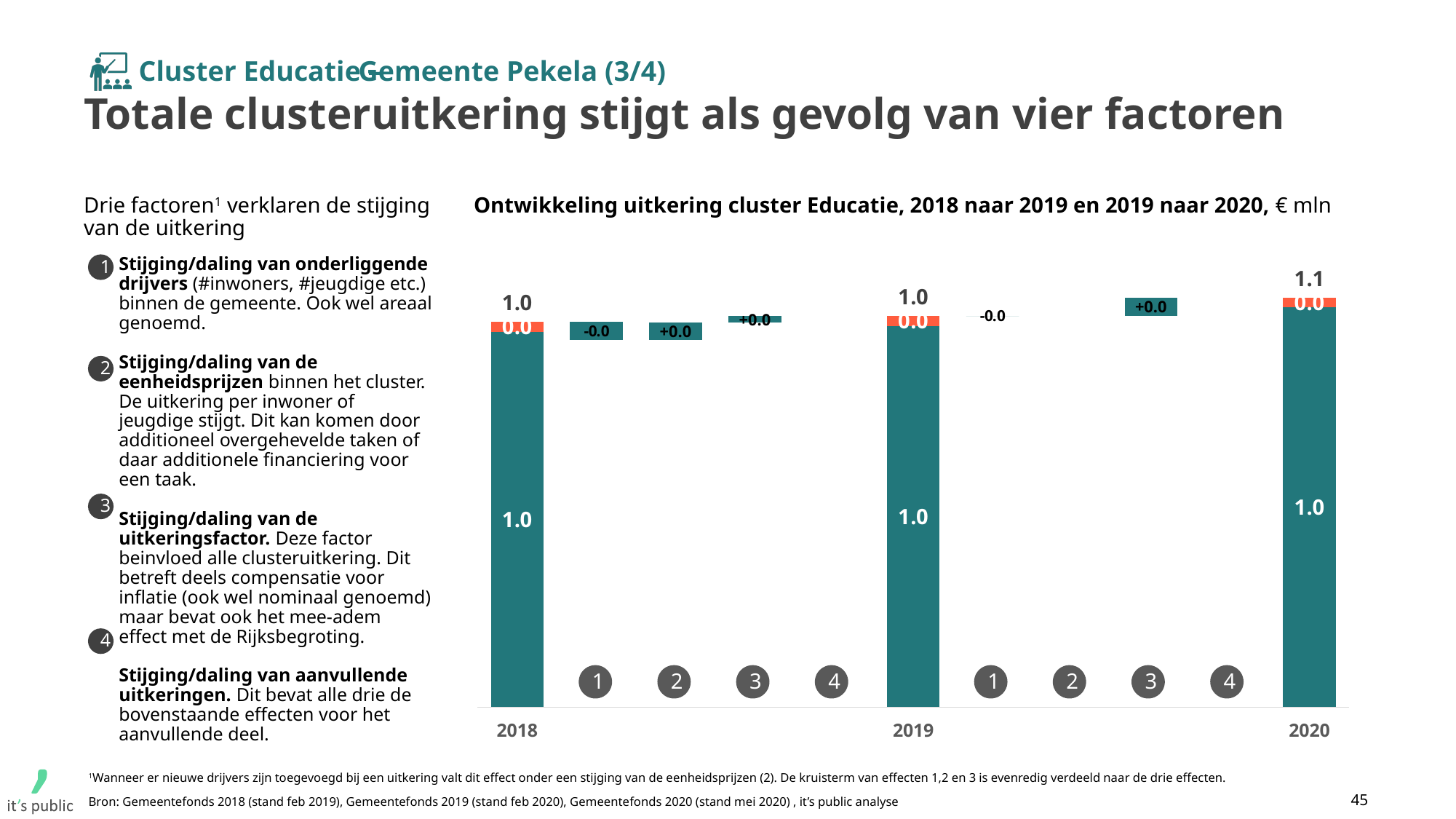
What is the label on the factor 2 bar between 2018 and 2019? +0.0 What is the value of the teal (lower) segment of the 2020 bar? 1.0 What is the total value shown above the 2019 bar? 1.0 What is the total value shown above the 2018 bar? 1.0 Which year has the highest total uitkering in the chart? 2020 What is the total value shown above the 2020 bar? 1.1 What is the difference between the 2020 total and the 2018 total? 0.1 What is the label on the factor 1 bar between 2018 and 2019? -0.0 What unit is stated in the chart title? € mln What is the value of the orange (upper) segment of the 2018 bar? 0.0 What kind of chart is shown on the slide? Bar chart (waterfall) What is the label on the factor 3 bar between 2019 and 2020? +0.0